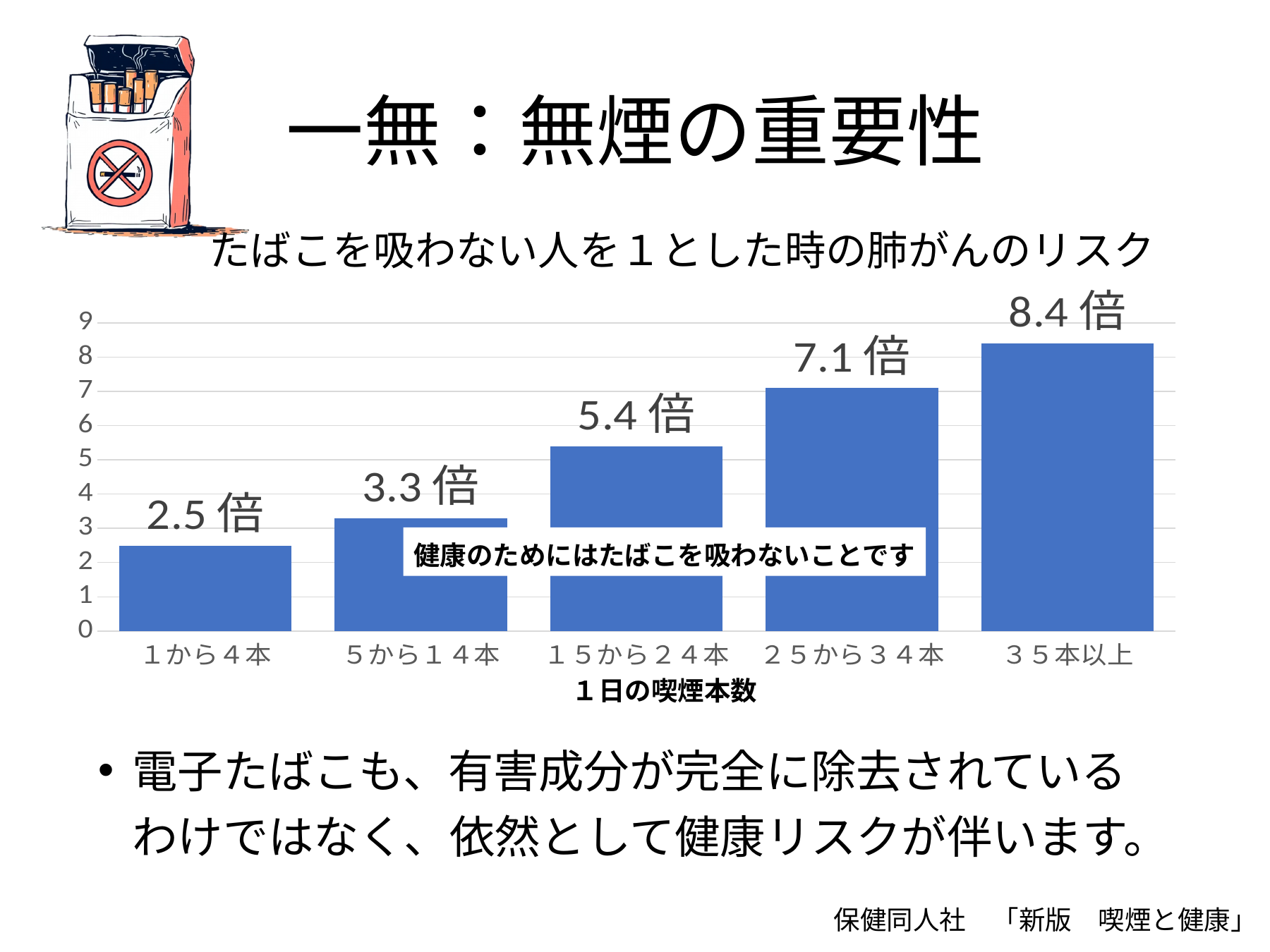
What kind of chart is shown on the slide? bar chart What is the value shown for １５から２４本? 5.4 倍 What is the x-axis title of the chart? １日の喫煙本数 Which category has the highest lung cancer risk? ３５本以上 Which is larger, the value for ５から１４本 or the value for １５から２４本? １５から２４本 Which category has the lowest lung cancer risk? １から４本 What is the difference between the values for ３５本以上 and １から４本? 5.9 What is the difference between the values for ２５から３４本 and ５から１４本? 3.8 What is the lung cancer risk value for the category ３５本以上? 8.4 倍 Do the values rise or fall as the number of cigarettes per day increases along the x axis? rise What is the lung cancer risk value for the category １から４本? 2.5 倍 How many categories are shown on the x axis? 5